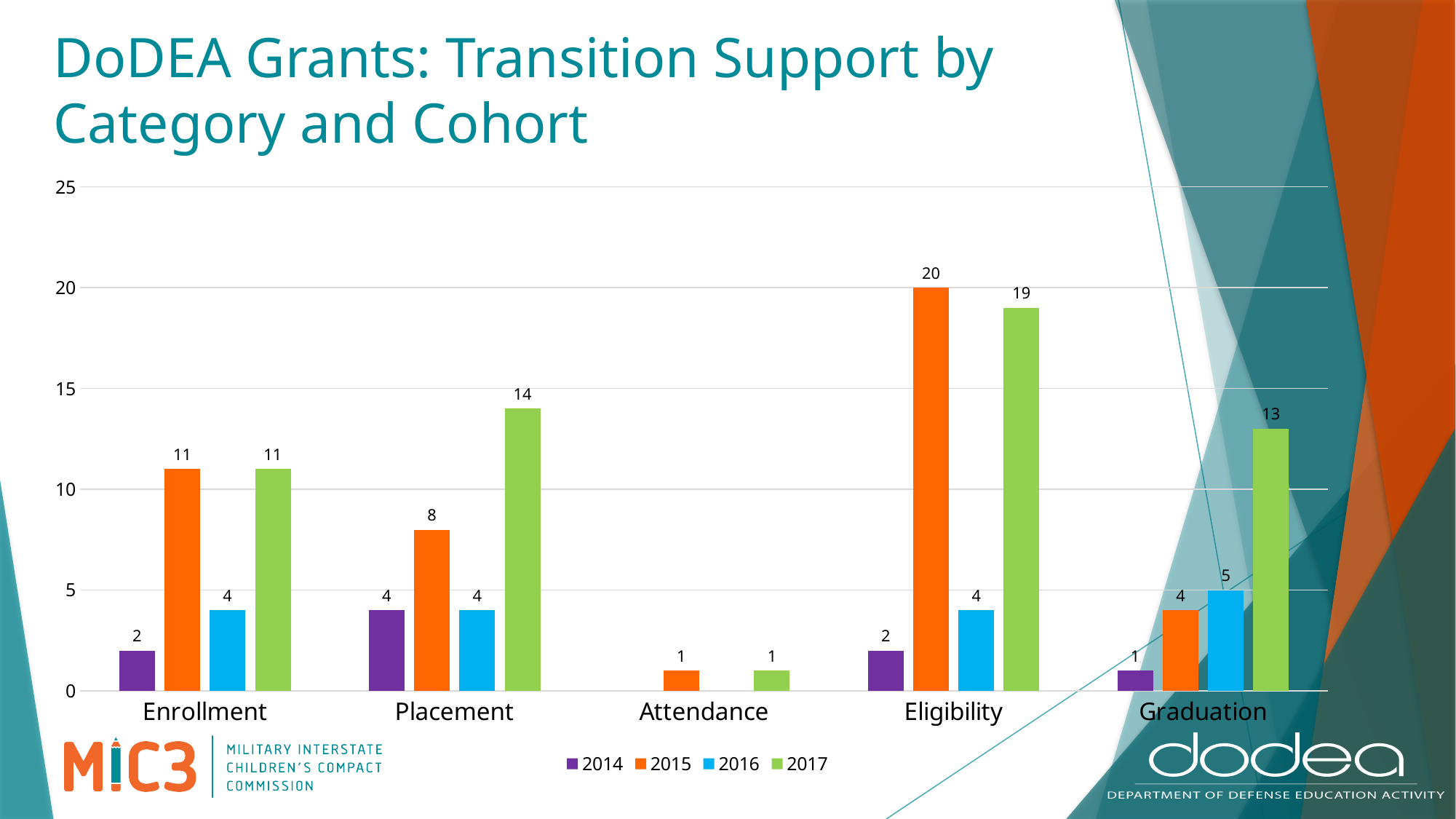
Is the value for 2017 in Graduation greater or less than 10? greater What is the value for 2015 in the Eligibility category? 20 What is the value for 2017 in the Placement category? 14 Which series is shown in orange in the legend? 2015 How many series does the legend list? 4 What is the difference between the 2015 and 2017 values in the Eligibility category? 1 What is the value for 2016 in the Graduation category? 5 How many categories are shown on the x axis? 5 Which is larger in the Placement category, the 2015 value or the 2017 value? 2017 Which category has the highest value for the 2017 series? Eligibility What kind of chart is shown on the slide? Bar chart Which category has the lowest value for the 2015 series? Attendance